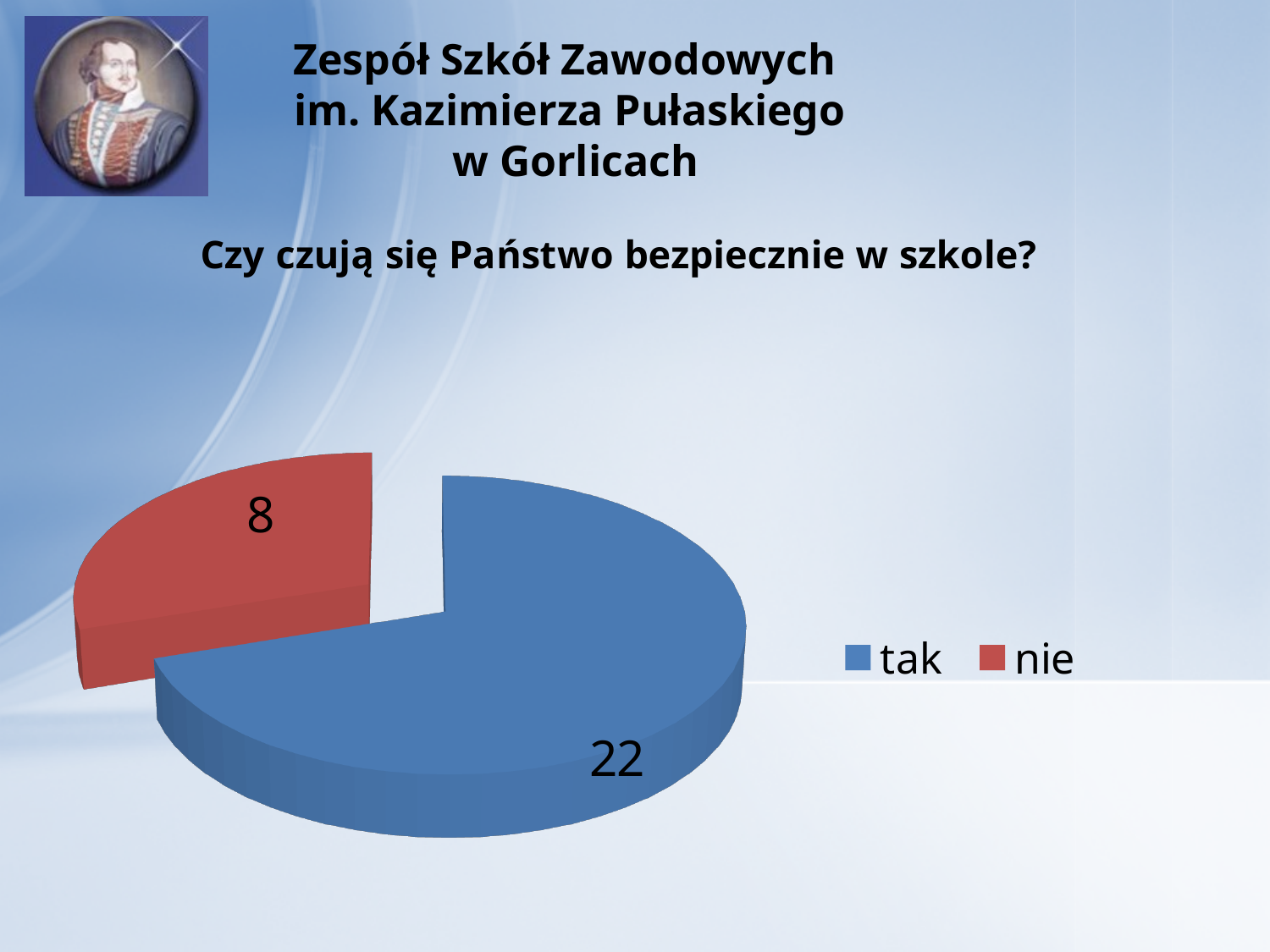
What value is shown for the "nie" slice? 8 What colour is the "nie" slice? red Which is larger, "tak" or "nie"? tak Which slice is the largest? tak What is the difference between the "tak" and "nie" values? 14 How many entries does the legend list? 2 What kind of chart is shown on the slide? pie chart What value is shown for the "tak" slice? 22 What is the total of all slices in the pie chart? 30 Which slice is the smallest? nie How many slices does the pie chart have? 2